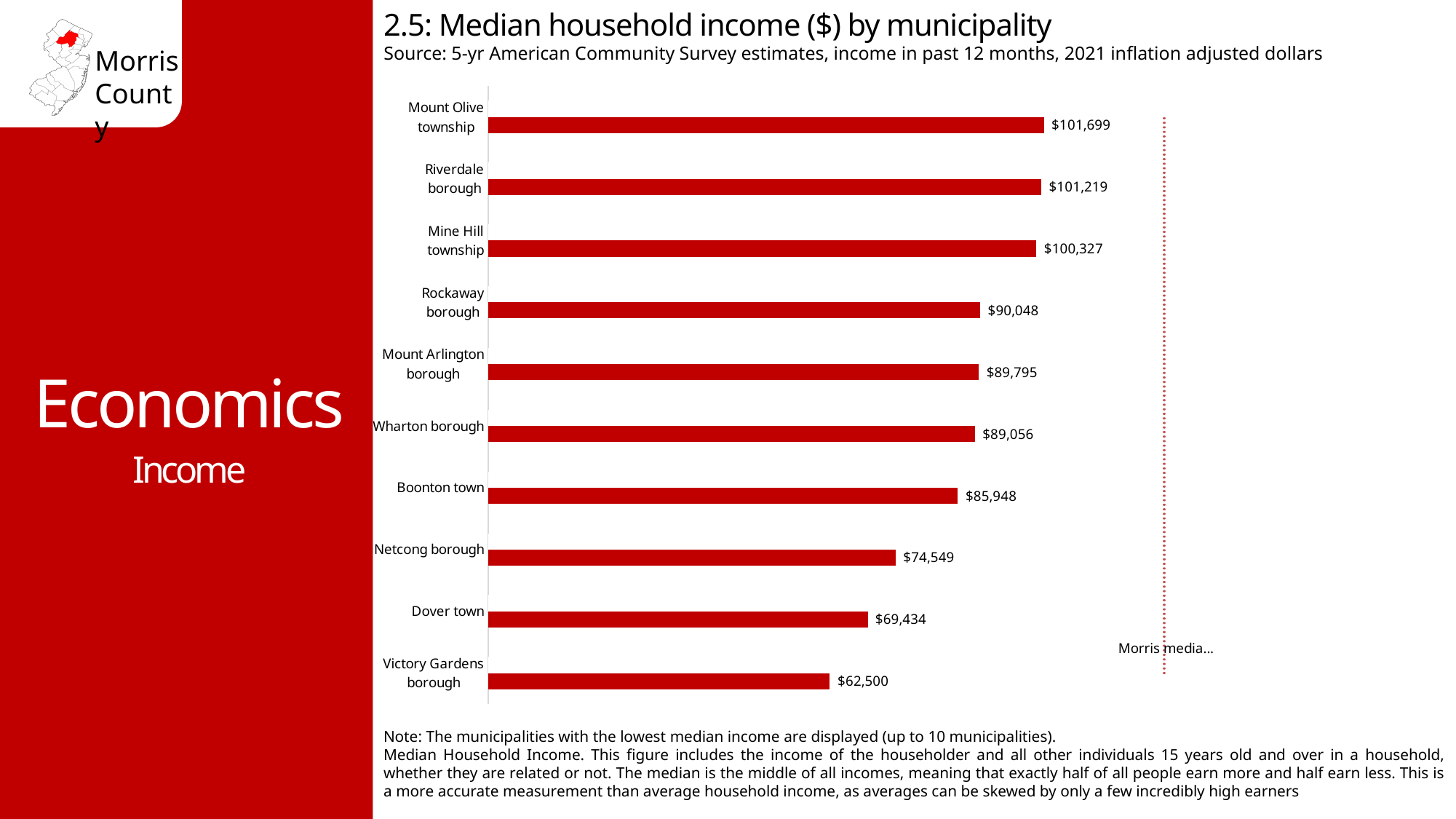
What is the median household income for Netcong borough? $74,549 Which has a higher median household income, Boonton town or Netcong borough? Boonton town What is the difference in median household income between Rockaway borough and Dover town? $20,614 Which municipality has the highest median household income shown on the chart? Mount Olive township Which has a higher median household income, Mine Hill township or Mount Arlington borough? Mine Hill township What is the difference in median household income between Mount Olive township and Victory Gardens borough? $39,199 What is the median household income for Mount Olive township? $101,699 What is the title of the chart? 2.5: Median household income ($) by municipality What is the median household income for Wharton borough? $89,056 Which municipality has the lowest median household income shown on the chart? Victory Gardens borough How many municipalities are shown on the chart? 10 What kind of chart is used to show median household income by municipality? Bar chart